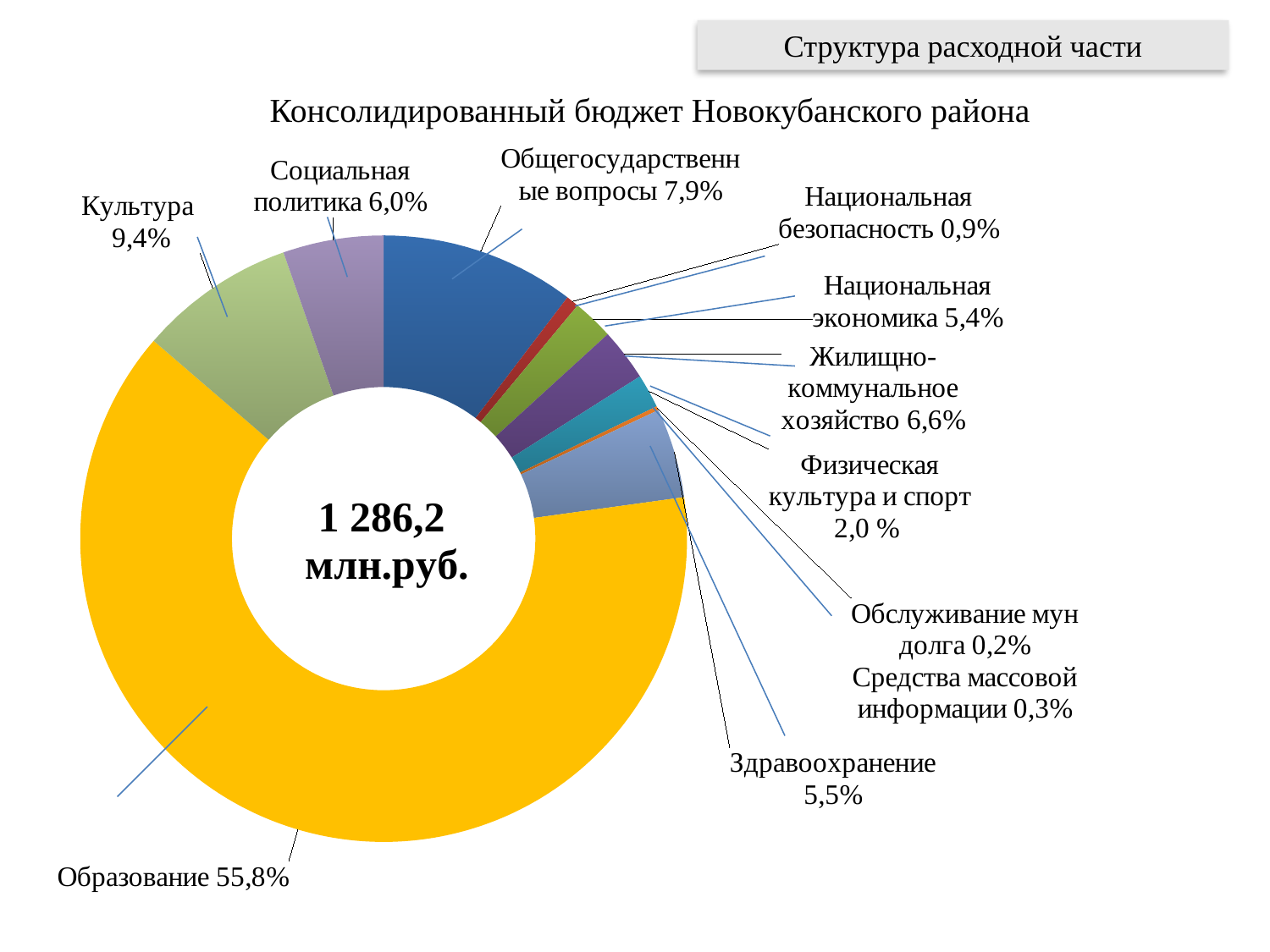
Which category has the smallest share of the chart? Обслуживание мун долга What share of the chart does Образование account for? 55,8% Which is larger: the share of Культура or the share of Национальная экономика? Культура What is the title of the chart? Консолидированный бюджет Новокубанского района What is the value shown for Культура? 9,4% What total amount is printed in the centre of the chart? 1 286,2 млн.руб. What percentage is shown for Жилищно-коммунальное хозяйство? 6,6% What is the value for Здравоохранение? 5,5% How many categories are shown in the chart? 11 What kind of chart is shown on the slide? Doughnut (pie) chart What is the difference between the shares of Общегосударственные вопросы and Социальная политика? 1,9% Which category has the largest share of the chart? Образование